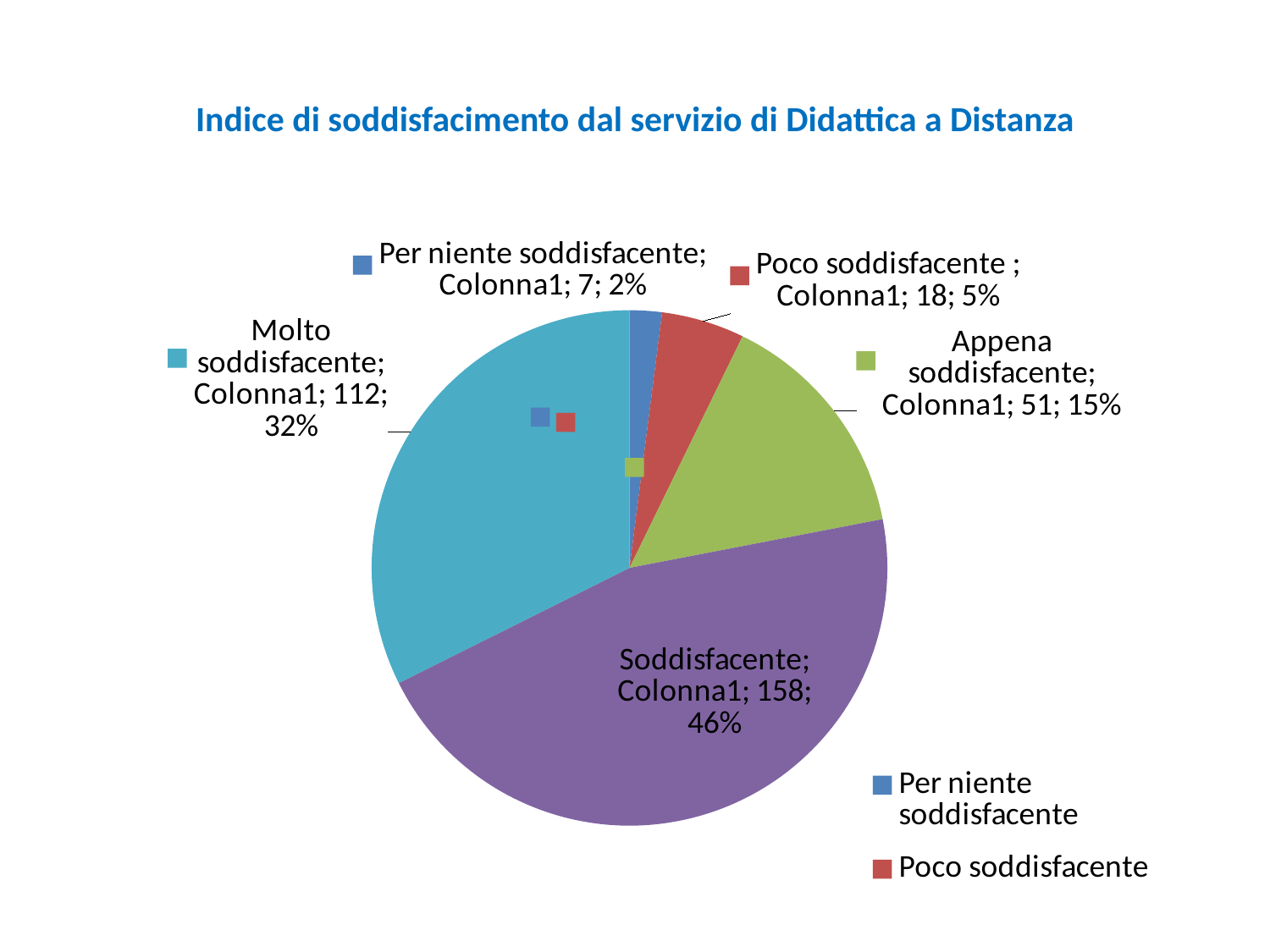
Which category has the smallest slice? Per niente soddisfacente What is the value for Appena soddisfacente? 51 What is the value for Soddisfacente? 158 What percentage share does Per niente soddisfacente have? 2% What type of chart is shown on the slide? pie chart How many slices does the pie chart have? 5 What is the value for Molto soddisfacente? 112 What percentage share does Poco soddisfacente have? 5% Which is larger, the value for Appena soddisfacente or the value for Poco soddisfacente? Appena soddisfacente What is the title of the chart? Indice di soddisfacimento dal servizio di Didattica a Distanza Which category has the largest slice? Soddisfacente What is the difference between the values for Soddisfacente and Molto soddisfacente? 46